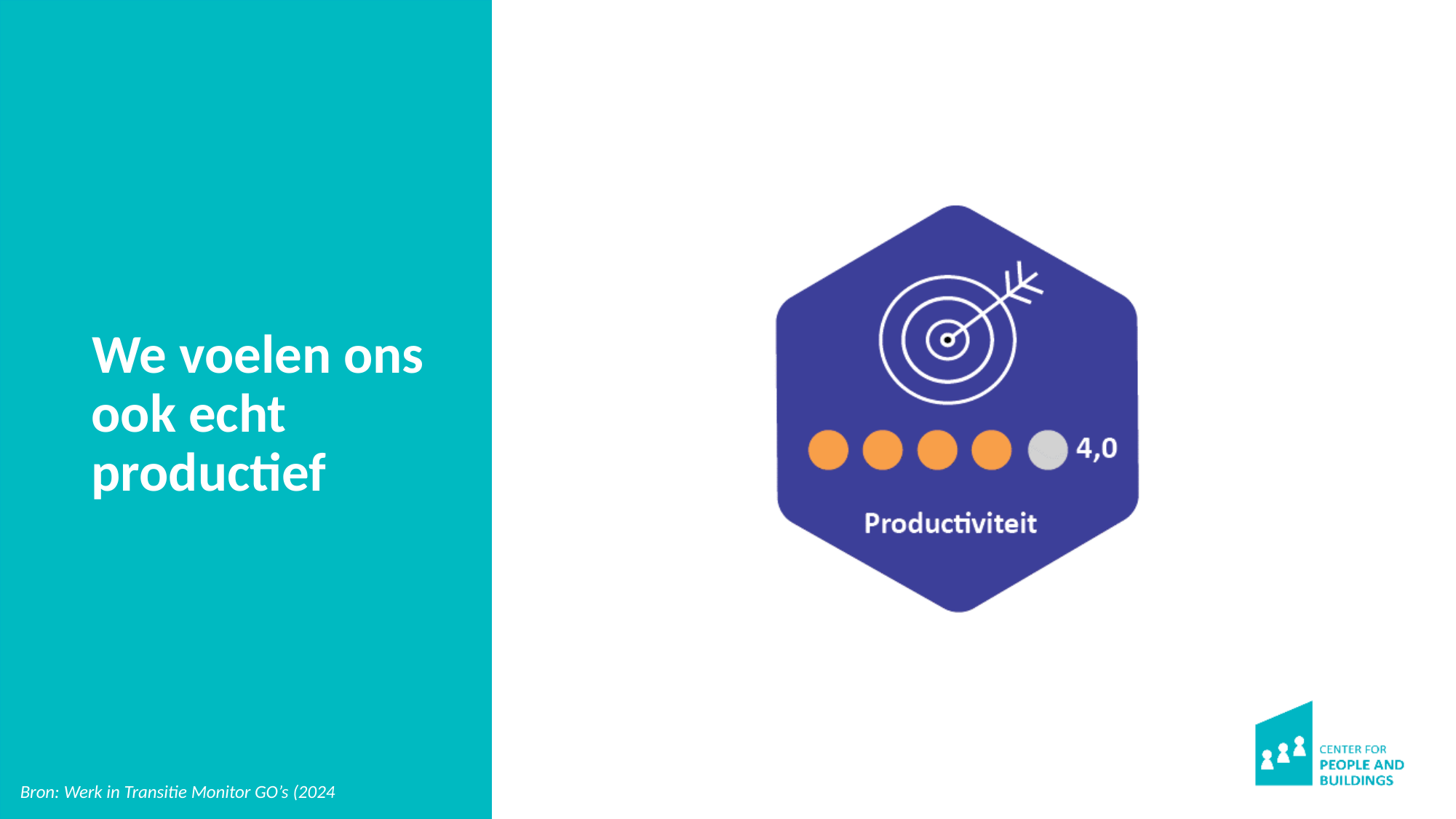
What label is printed beneath the rating dots in the hexagon? Productiviteit How many of the rating dots are grey? 1 How many of the rating dots are filled orange? 4 What colour is the hexagon that contains the Productiviteit rating? Blue (purple-blue) Is the Productiviteit score greater or less than 3? greater Is the Productiviteit score greater or less than 5? less What score is shown for Productiviteit on the slide? 4,0 How many dots are shown in the rating row under the target icon? 5